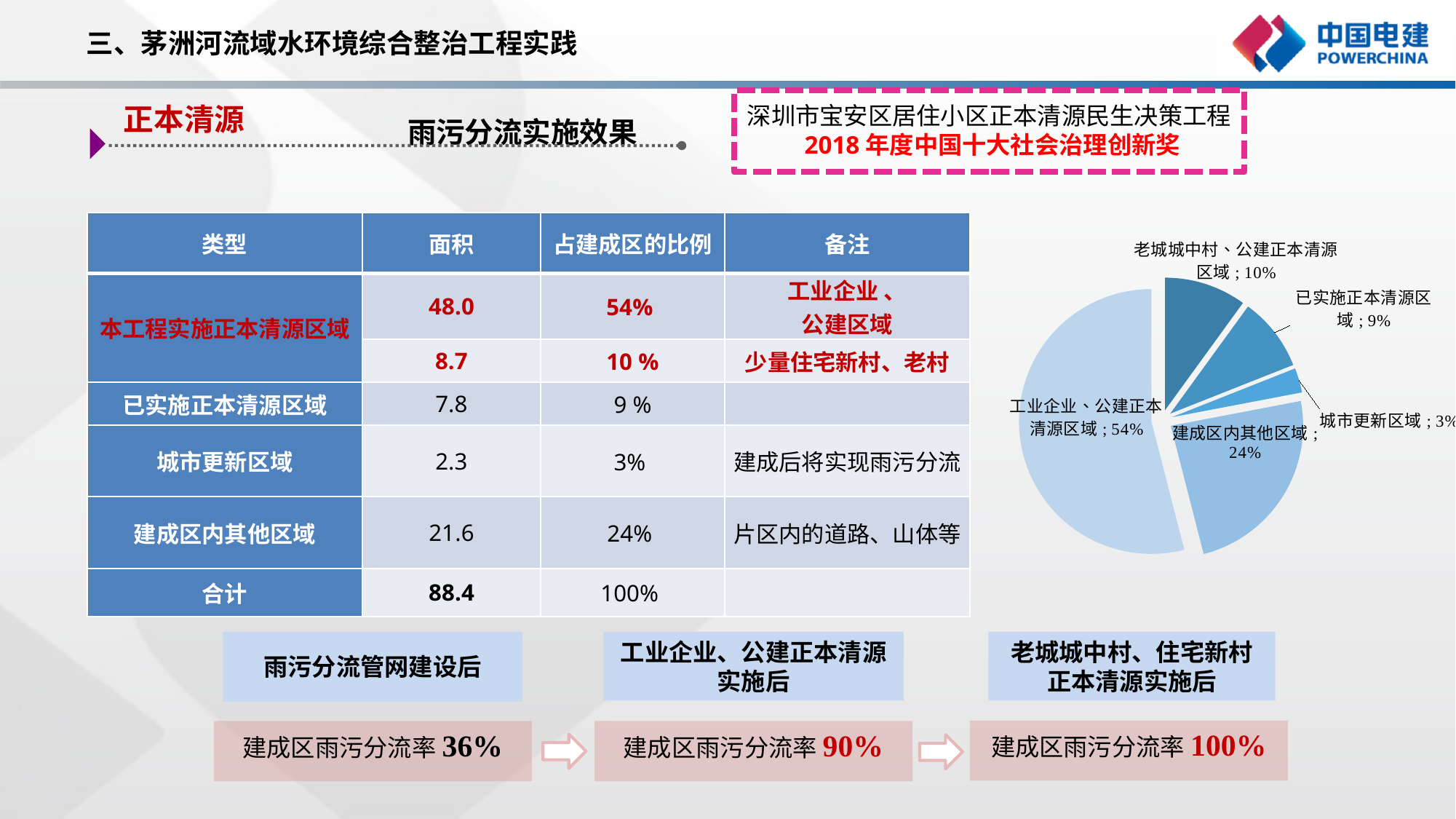
In the pie chart, what is the combined share of 老城城中村、公建正本清源区域 and 已实施正本清源区域? 19% In the pie chart, what share is labelled for 老城城中村、公建正本清源区域? 10% In the pie chart, what is the difference in percentage points between 工业企业、公建正本清源区域 and 建成区内其他区域? 30 percentage points What kind of chart is shown on the right side of the slide? pie chart In the pie chart, which is larger: 建成区内其他区域 or 老城城中村、公建正本清源区域? 建成区内其他区域 In the pie chart, what share is labelled for 城市更新区域? 3% In the pie chart, what share is labelled for 建成区内其他区域? 24% How many slices does the pie chart have? 5 Which slice of the pie chart is the largest? 工业企业、公建正本清源区域 Which slice of the pie chart is the smallest? 城市更新区域